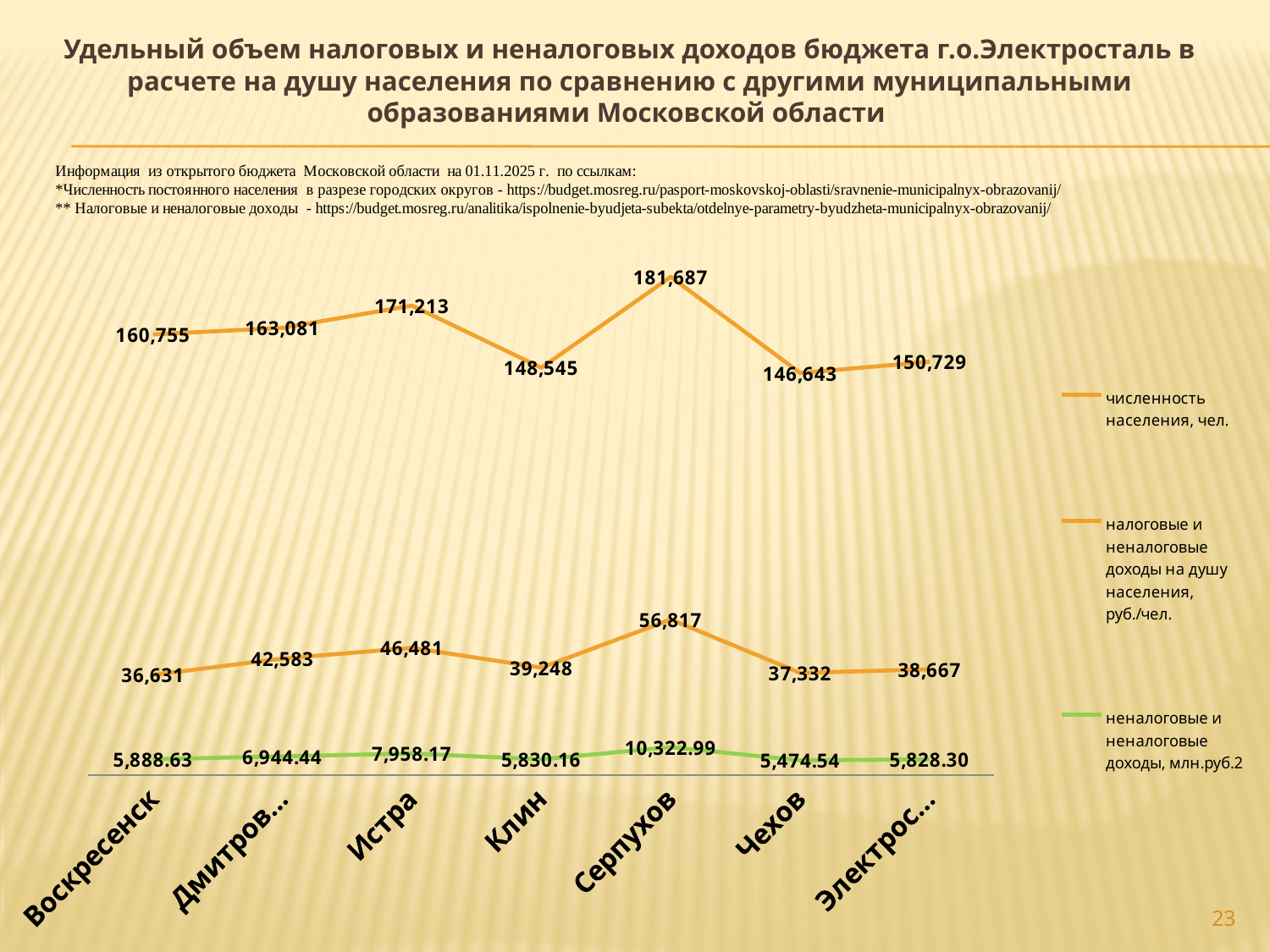
Which has the larger population value, Истра or Клин? Истра Which municipality has the lowest population value on the chart? Чехов What is the per-capita tax and non-tax revenue (руб./чел.) value shown for Истра? 46,481 Which municipality has the lowest revenue in млн.руб.? Чехов Which municipality has the highest population value on the chart? Серпухов How many series does the chart legend list? 3 Which municipality has the highest per-capita revenue (руб./чел.) value? Серпухов What is the difference between the population values of Истра and Воскресенск? 10,458 What is the revenue in млн.руб. shown for Клин? 5,830.16 How many municipalities are shown on the x axis of the chart? 7 What is the difference between the per-capita revenue (руб./чел.) of Серпухов and Чехов? 19,485 What is the population (численность населения, чел.) value shown for Серпухов? 181,687